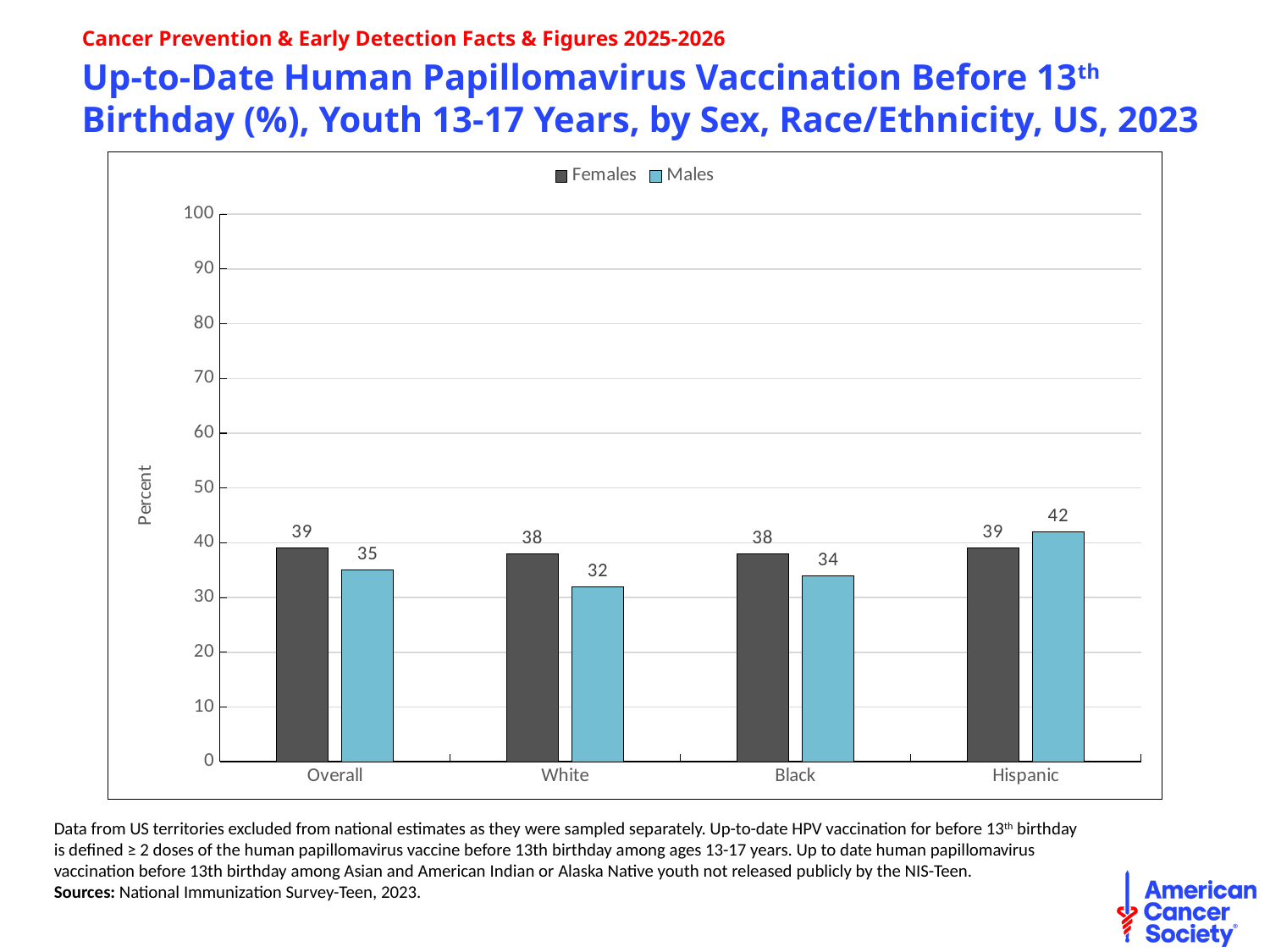
In the Hispanic category, which is larger, the Females value or the Males value? Males Which category has the highest value for Males? Hispanic What is the value for Males in the White category? 32 What is the value for Males in the Hispanic category? 42 How many categories are shown on the x axis? 4 Is the value for Males in the Overall category greater or less than 40? less What is the difference between the Females and Males values in the Black category? 4 What is the difference between the Males values for Hispanic and White? 10 What is the value for Females in the Overall category? 39 Which category has the lowest value for Males? White What kind of chart is shown on the slide? bar chart How many series does the legend list? 2